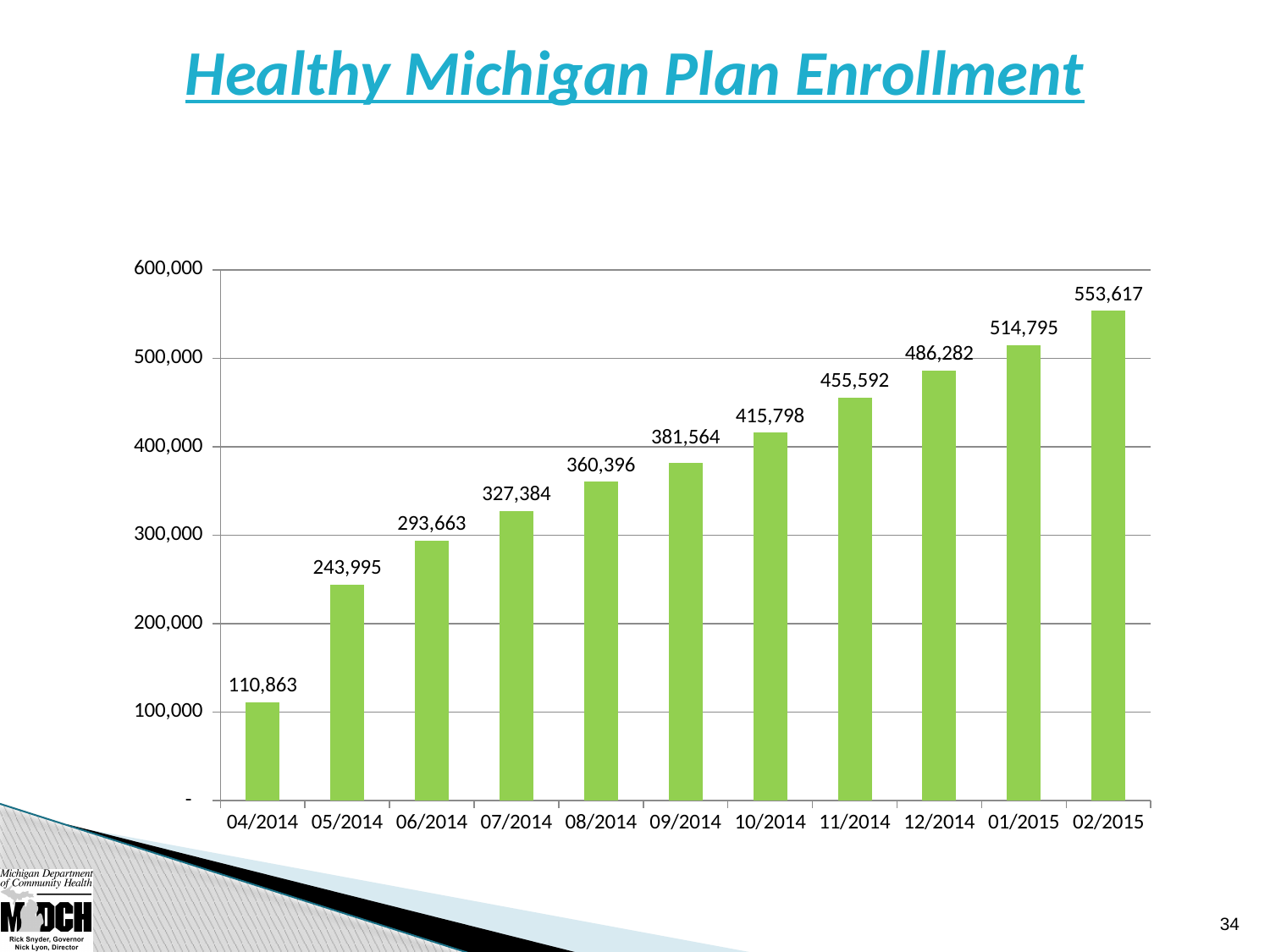
Do the enrollment values rise or fall from 04/2014 to 02/2015? rise Which is larger, the enrollment for 07/2014 or for 10/2014? 10/2014 Which month has the highest enrollment? 02/2015 What is the difference in enrollment between 05/2014 and 04/2014? 133,132 What is the enrollment value for 09/2014? 381,564 What kind of chart is shown on the slide? bar chart What is the enrollment value for 02/2015? 553,617 What is the difference in enrollment between 02/2015 and 01/2015? 38,822 How many months are shown on the x axis? 11 Which month has the lowest enrollment? 04/2014 What is the enrollment value for 04/2014? 110,863 Is the enrollment value for 11/2014 greater or less than 400,000? greater